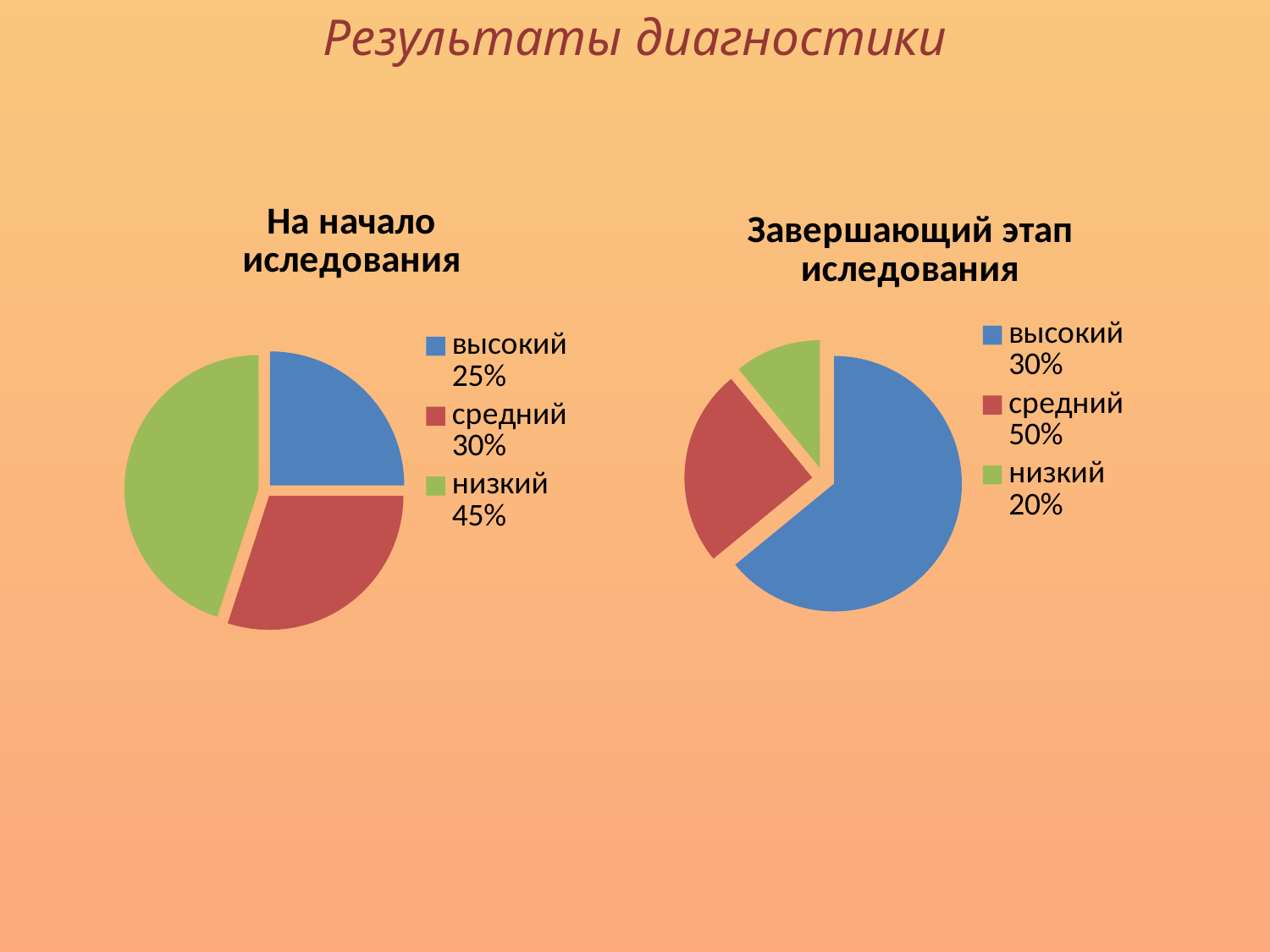
What type of chart is the chart titled "На начало иследования"? pie chart In the chart titled "На начало иследования", what percentage is shown for "высокий"? 25% In the chart titled "На начало иследования", what is the difference between the shares of "низкий" and "высокий"? 20% In the chart titled "На начало иследования", what colour represents "низкий"? green How many categories does the legend of the chart titled "Завершающий этап иследования" list? 3 In the chart titled "На начало иследования", what percentage is shown for "низкий"? 45% In the chart titled "На начало иследования", which category has the largest share? низкий In the chart titled "Завершающий этап иследования", what percentage is shown for "низкий"? 20% In the chart titled "На начало иследования", which category has the smallest share? высокий In the chart titled "На начало иследования", what percentage is shown for "средний"? 30% In the chart titled "Завершающий этап иследования", what percentage is shown for "средний"? 50% In the chart titled "Завершающий этап иследования", what percentage is shown for "высокий"? 30%